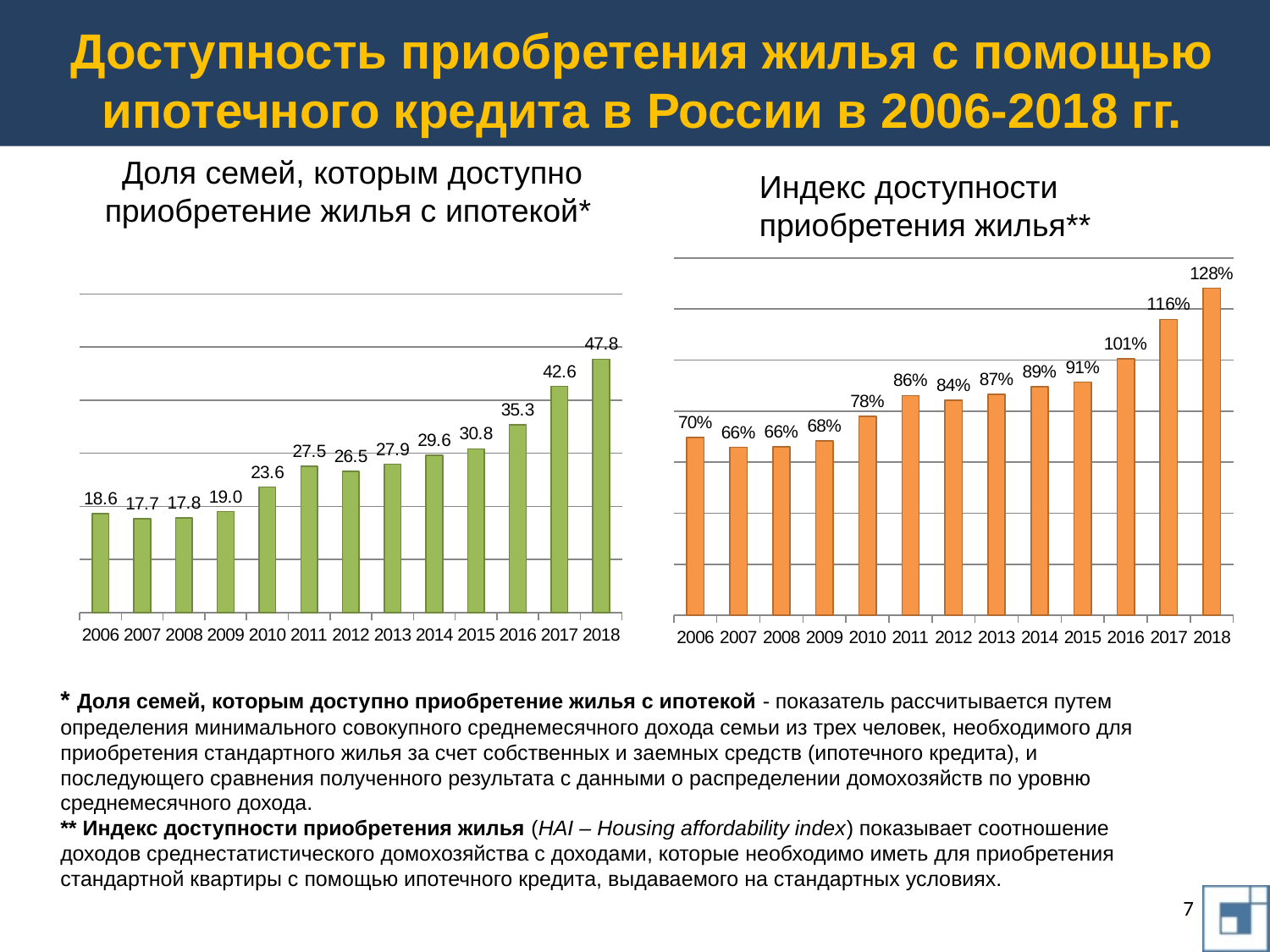
In the right chart (Индекс доступности приобретения жилья), what is the value for 2006? 70% In the left chart (Доля семей, которым доступно приобретение жилья с ипотекой), what is the value for 2018? 47.8 In the right chart (Индекс доступности приобретения жилья), which year has the highest value? 2018 In the left chart (Доля семей, которым доступно приобретение жилья с ипотекой), which is larger: the value for 2011 or the value for 2012? 2011 In the left chart (Доля семей, которым доступно приобретение жилья с ипотекой), what is the difference between the values for 2018 and 2006? 29.2 In the left chart (Доля семей, которым доступно приобретение жилья с ипотекой), what is the value for 2010? 23.6 In the right chart (Индекс доступности приобретения жилья), what is the value for 2016? 101% In the left chart (Доля семей, которым доступно приобретение жилья с ипотекой), which year has the lowest value? 2007 In the left chart (Доля семей, которым доступно приобретение жилья с ипотекой), how many years are shown on the x axis? 13 In the right chart (Индекс доступности приобретения жилья), what kind of chart is it? Bar chart In the right chart (Индекс доступности приобретения жилья), do the values generally rise or fall from 2013 to 2018? Rise In the right chart (Индекс доступности приобретения жилья), what is the difference between the values for 2018 and 2017? 12%